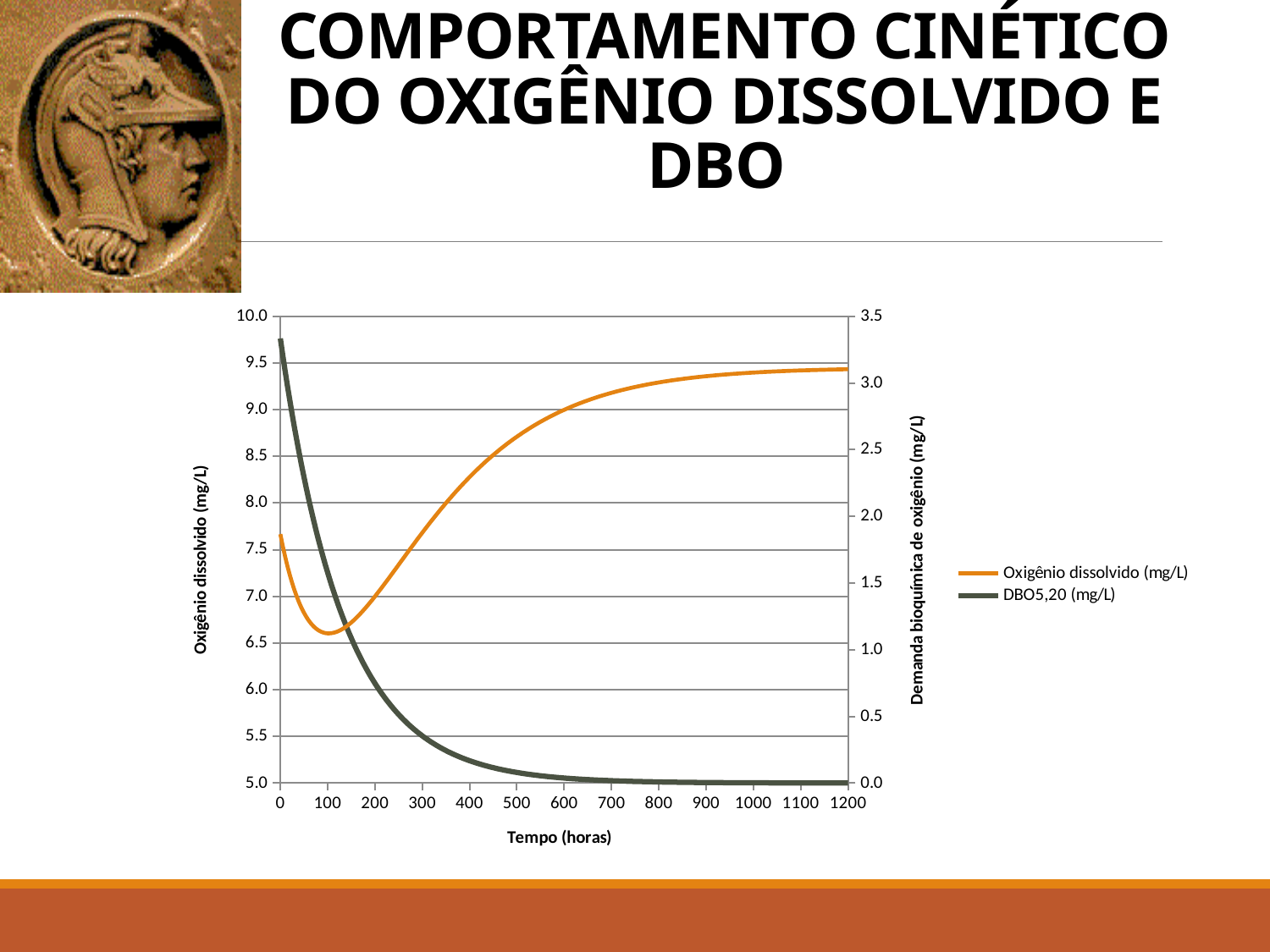
Is the value of DBO5,20 (mg/L) at 600 hours greater or less than 0.5? less Does the DBO5,20 (mg/L) series rise or fall as time increases along the x axis? fall Is the value of Oxigênio dissolvido (mg/L) at 1200 hours greater or less than 9.0? greater What are the two series named in the legend? Oxigênio dissolvido (mg/L) and DBO5,20 (mg/L) What kind of chart is shown on the slide? line chart How many series does the legend list? 2 What is the title of the x axis? Tempo (horas) Which is larger for Oxigênio dissolvido (mg/L): the value at 0 hours or the value at 1200 hours? 1200 hours Does the Oxigênio dissolvido (mg/L) series rise or fall between 0 and 100 hours? fall Is the value of DBO5,20 (mg/L) at 0 hours greater or less than 3.0? greater Does the Oxigênio dissolvido (mg/L) series rise or fall between 300 and 1200 hours? rise